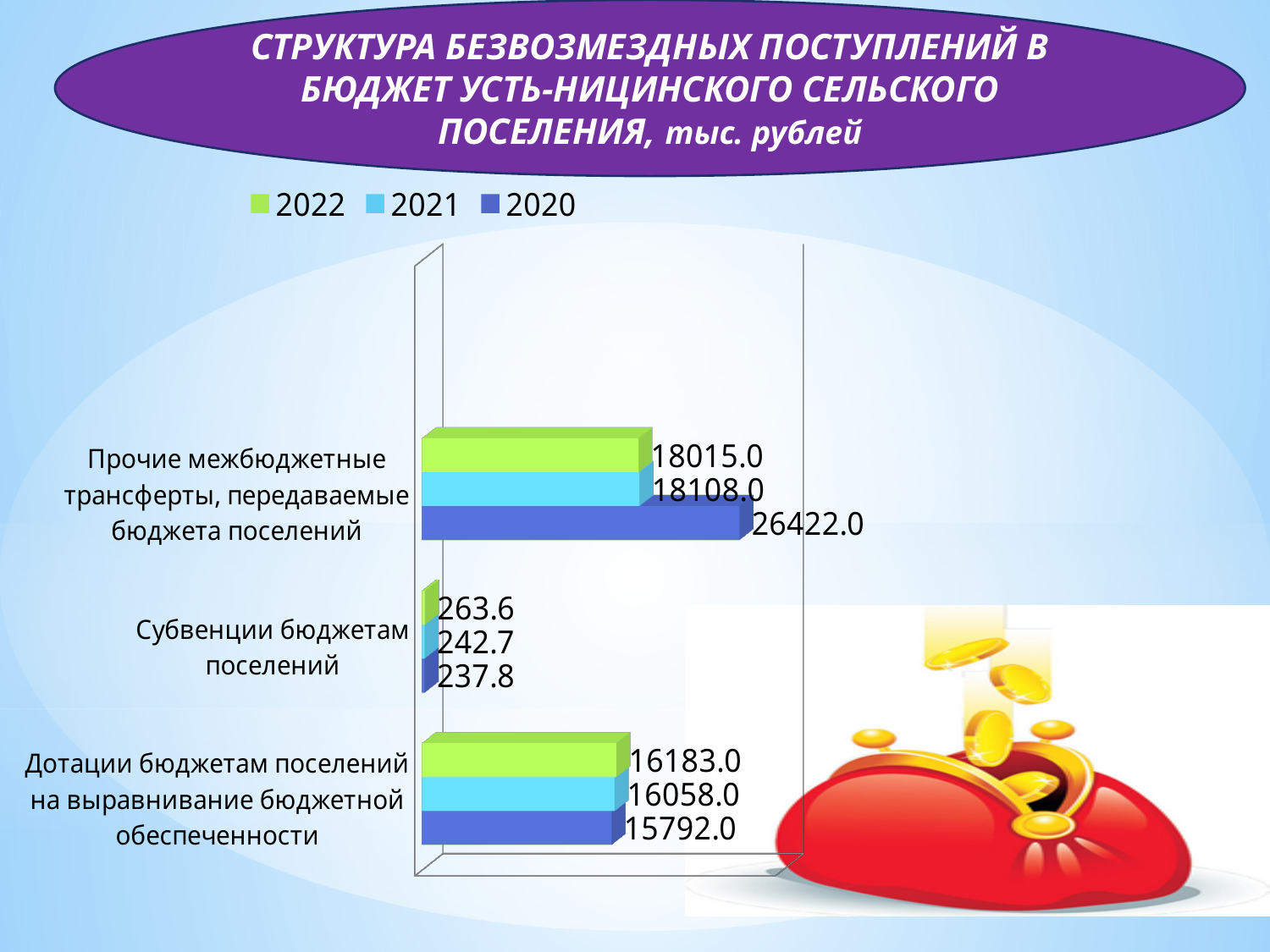
What is the value for 2020 in the category "Прочие межбюджетные трансферты, передаваемые бюджета поселений"? 26422.0 What is the difference between the 2022 and 2020 values for "Дотации бюджетам поселений на выравнивание бюджетной обеспеченности"? 391.0 Which is larger for "Субвенции бюджетам поселений": the 2021 value or the 2020 value? 2021 What is the value for 2022 in the category "Прочие межбюджетные трансферты, передаваемые бюджета поселений"? 18015.0 How many categories are shown on the chart? 3 How many series does the legend list? 3 What is the value for 2022 in the category "Субвенции бюджетам поселений"? 263.6 What is the value for 2021 in the category "Дотации бюджетам поселений на выравнивание бюджетной обеспеченности"? 16058.0 What kind of chart is shown on the slide? Bar chart What is the difference between the 2020 and 2022 values for "Прочие межбюджетные трансферты, передаваемые бюджета поселений"? 8407.0 Which category has the lowest values across all three years? Субвенции бюджетам поселений Which year has the highest value in the category "Прочие межбюджетные трансферты, передаваемые бюджета поселений"? 2020